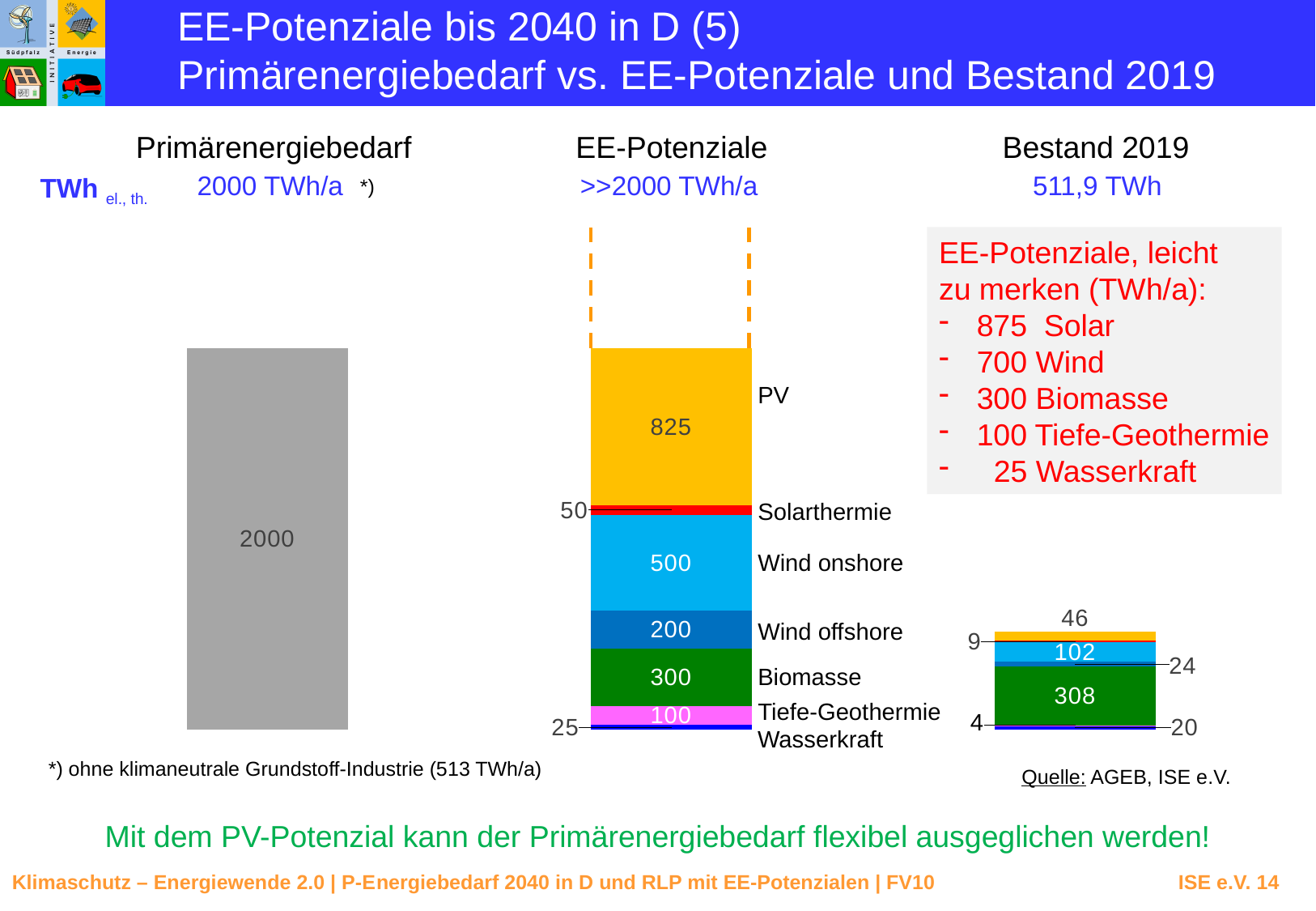
In the EE-Potenziale stacked bar, which segment is the largest? PV In the EE-Potenziale stacked bar, what is the difference between Wind onshore and Wind offshore? 300 In the EE-Potenziale stacked bar, which is larger, Biomasse or Wind offshore? Biomasse In the EE-Potenziale stacked bar, which segment is the smallest? Wasserkraft What total is given for the Bestand 2019 bar? 511,9 TWh What value is printed on the Primärenergiebedarf bar? 2000 How many segments make up the EE-Potenziale stacked bar? 7 In the EE-Potenziale stacked bar, what is the value for PV? 825 In the EE-Potenziale stacked bar, what is the value for Tiefe-Geothermie? 100 In the Bestand 2019 stacked bar, what is the value of the largest segment? 308 In the EE-Potenziale stacked bar, what is the value for Wind onshore? 500 What is the total of all segments in the EE-Potenziale stacked bar? 2000